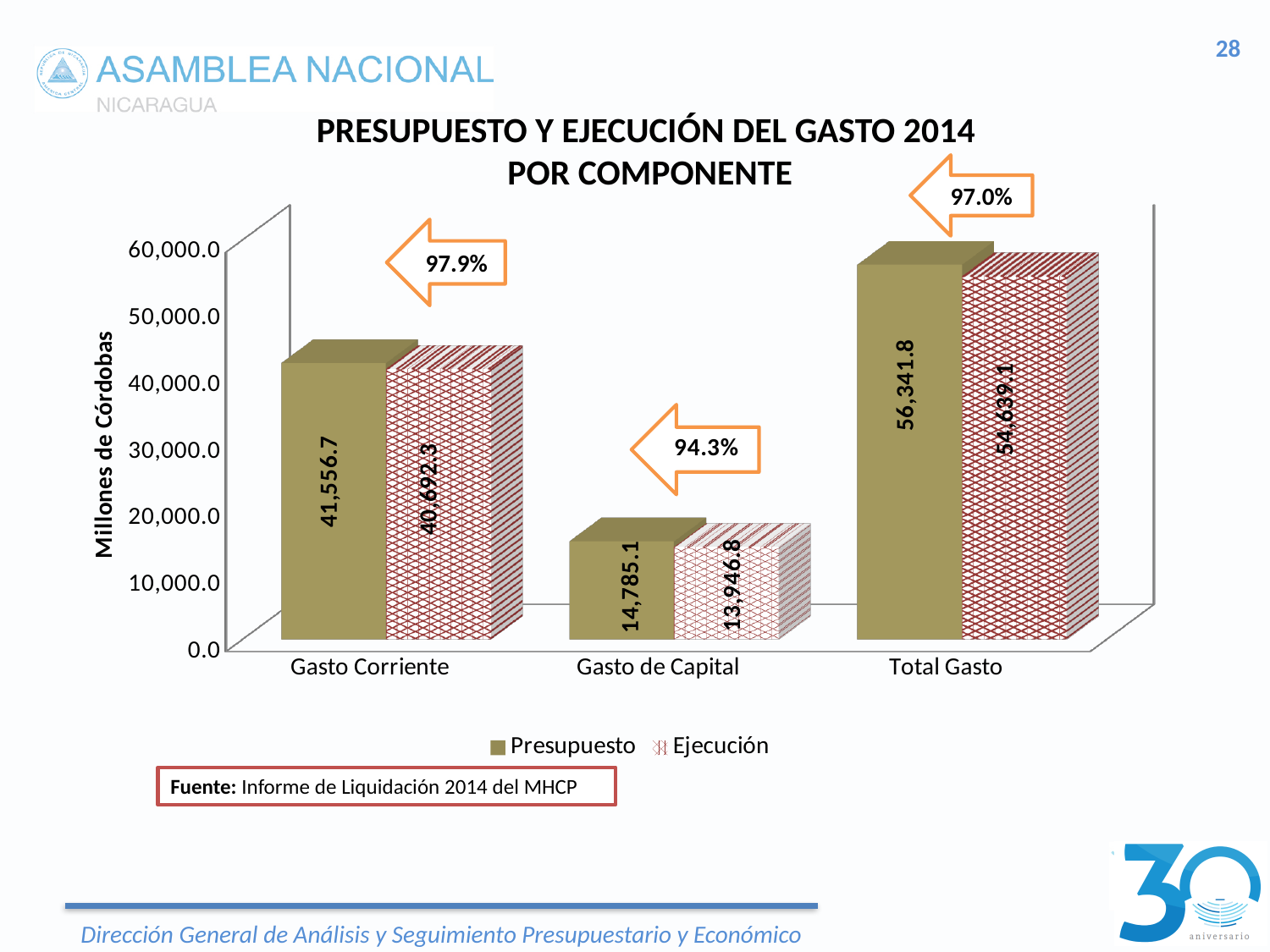
How many series does the legend list? 2 What is the difference between Presupuesto and Ejecución for Total Gasto? 1,702.7 Which category has the highest Ejecución value? Total Gasto What execution percentage is shown in the arrow above Gasto de Capital? 94.3% Which category has the lowest Presupuesto value? Gasto de Capital What is the Presupuesto value for Gasto Corriente? 41,556.7 What is the Ejecución value for Total Gasto? 54,639.1 What is the Ejecución value for Gasto de Capital? 13,946.8 What is the difference between Presupuesto and Ejecución for Gasto Corriente? 864.4 Which is larger for Gasto de Capital, Presupuesto or Ejecución? Presupuesto What kind of chart is shown on the slide? Bar chart How many categories are shown on the x axis? 3